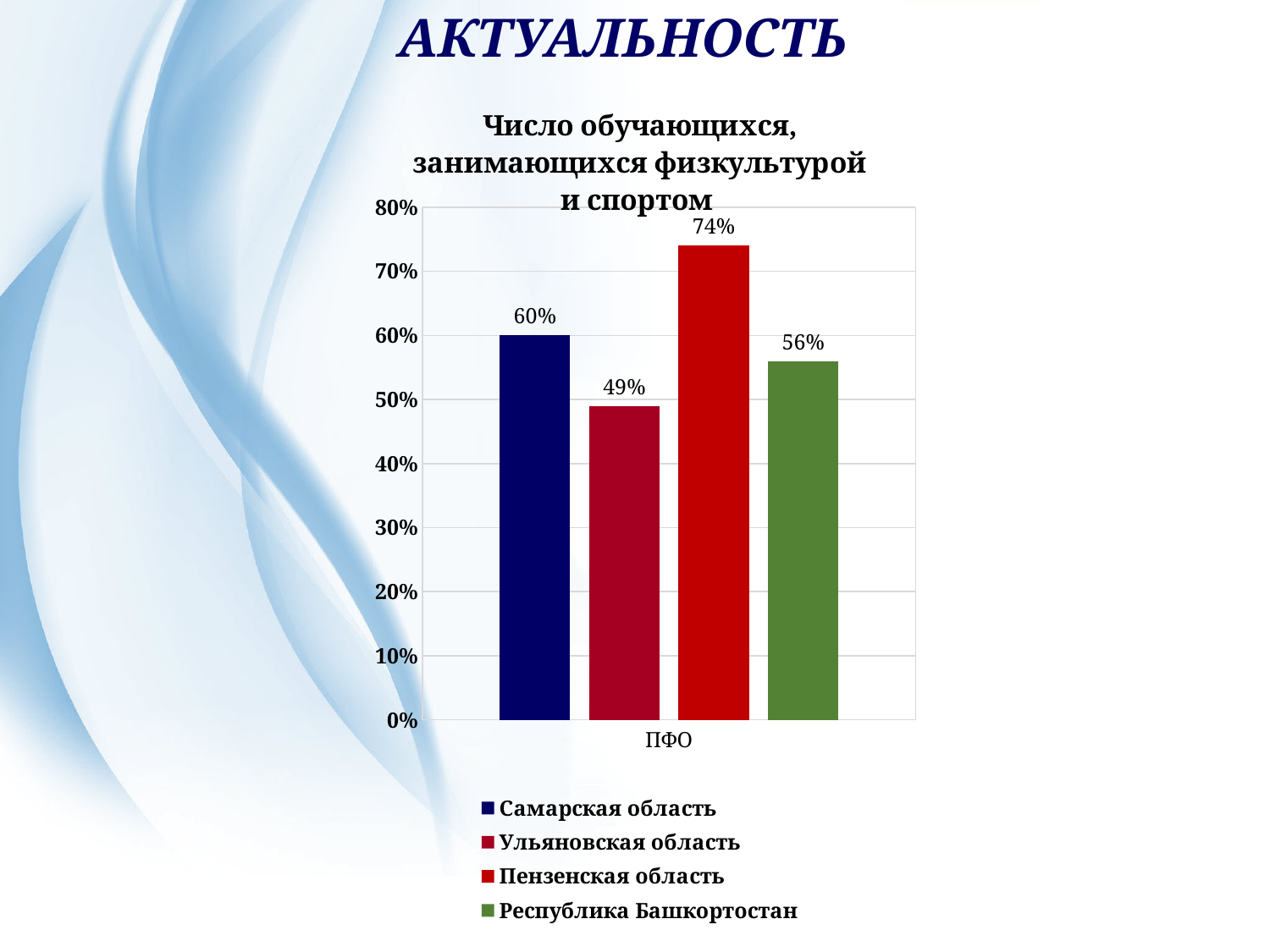
What is the value for Республика Башкортостан? 56% Is the value for Республика Башкортостан greater or less than 50%? greater What is the category label on the x axis? ПФО What is the value for Пензенская область? 74% What is the value for Самарская область? 60% How many series does the legend list? 4 What kind of chart is shown? bar chart What is the difference between the values for Пензенская область and Ульяновская область? 25% What is the value for Ульяновская область? 49% Which region has the lowest value? Ульяновская область Which region has the highest value? Пензенская область Which is larger, the value for Самарская область or Республика Башкортостан? Самарская область